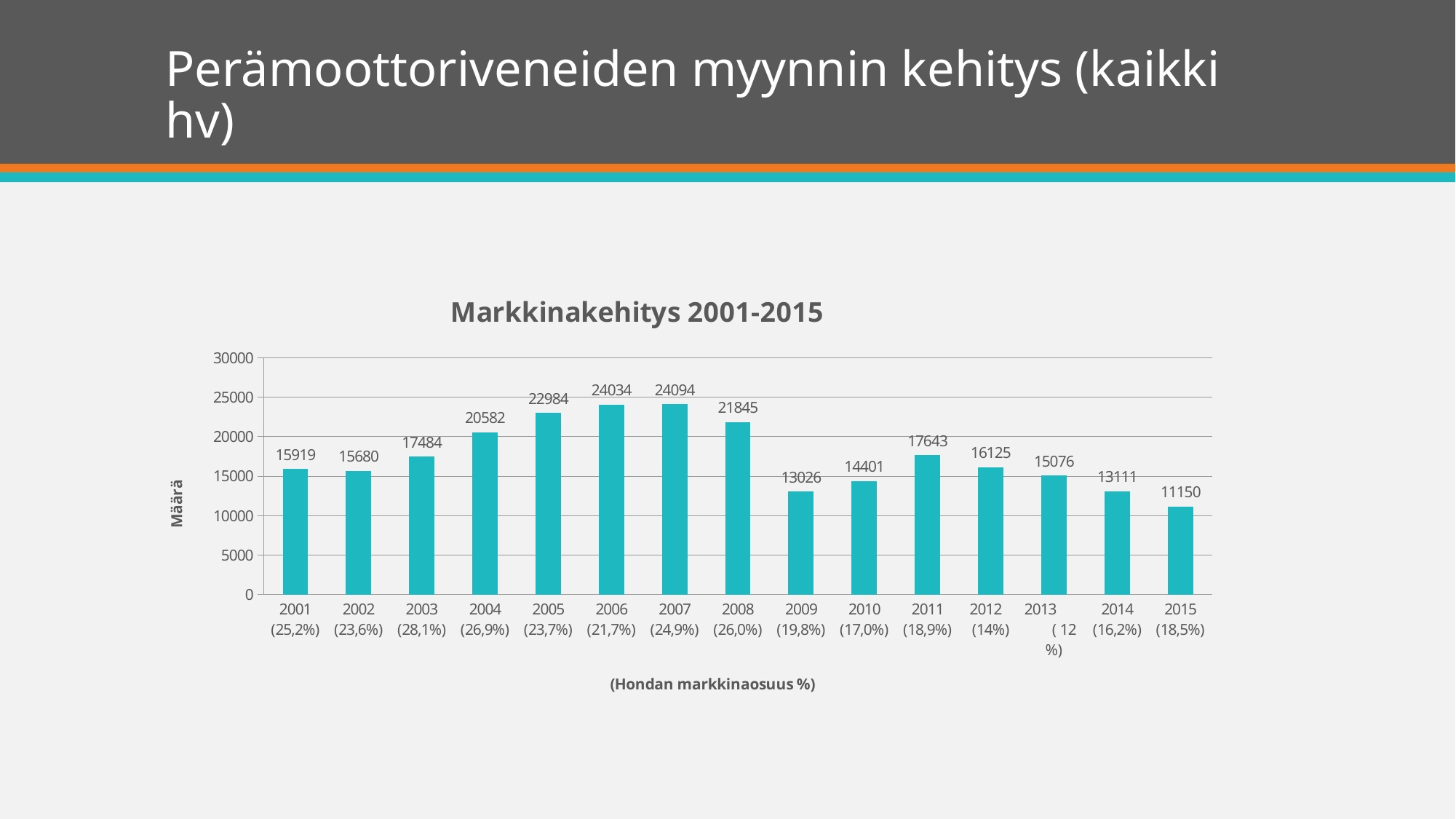
What is the difference between the values for 2008 and 2009? 8819 Which year has the highest value? 2007 What is the value for 2007? 24094 What is the title of the chart? Markkinakehitys 2001-2015 Which year has the lowest value? 2015 What kind of chart is this? bar chart Is the value for 2005 greater or less than 20000? greater What is the value for 2011? 17643 How many years are shown on the x axis? 15 Which is larger, the value for 2003 or the value for 2012? 2003 What is the value for 2015? 11150 Do the values rise or fall from 2011 to 2015? fall